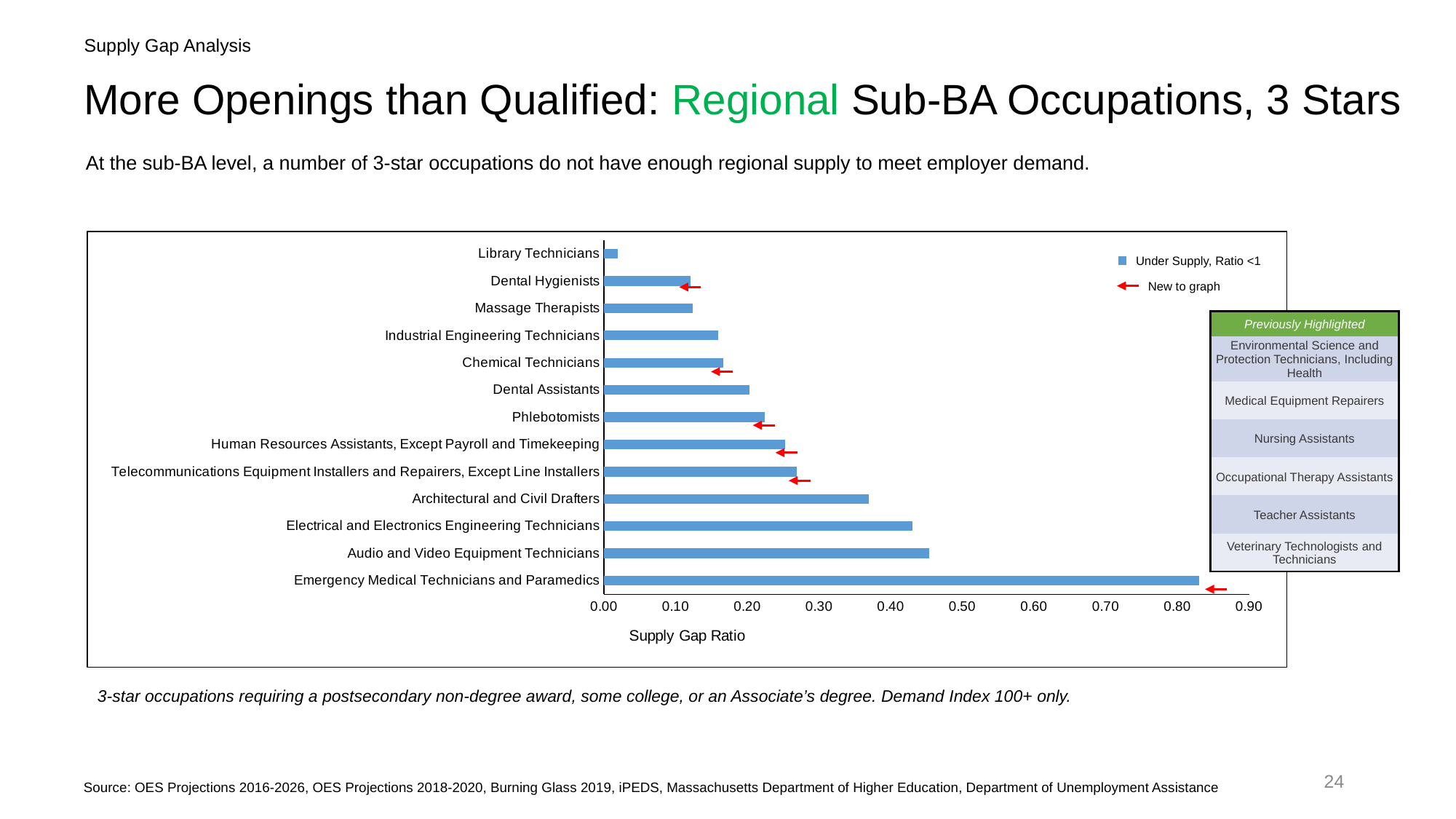
Is the Supply Gap Ratio for Audio and Video Equipment Technicians greater or less than 0.40? greater Is the Supply Gap Ratio for Emergency Medical Technicians and Paramedics greater or less than 0.80? greater Is the Supply Gap Ratio for Architectural and Civil Drafters greater or less than 0.30? greater How many occupations are plotted in the chart? 13 Which occupation has the lowest Supply Gap Ratio? Library Technicians How many occupations in the chart are marked with a red arrow as new to graph? 6 What kind of chart is shown on the slide? bar chart Which has a larger Supply Gap Ratio, Architectural and Civil Drafters or Dental Assistants? Architectural and Civil Drafters Which occupation has the highest Supply Gap Ratio? Emergency Medical Technicians and Paramedics What is the title of the horizontal axis of the chart? Supply Gap Ratio